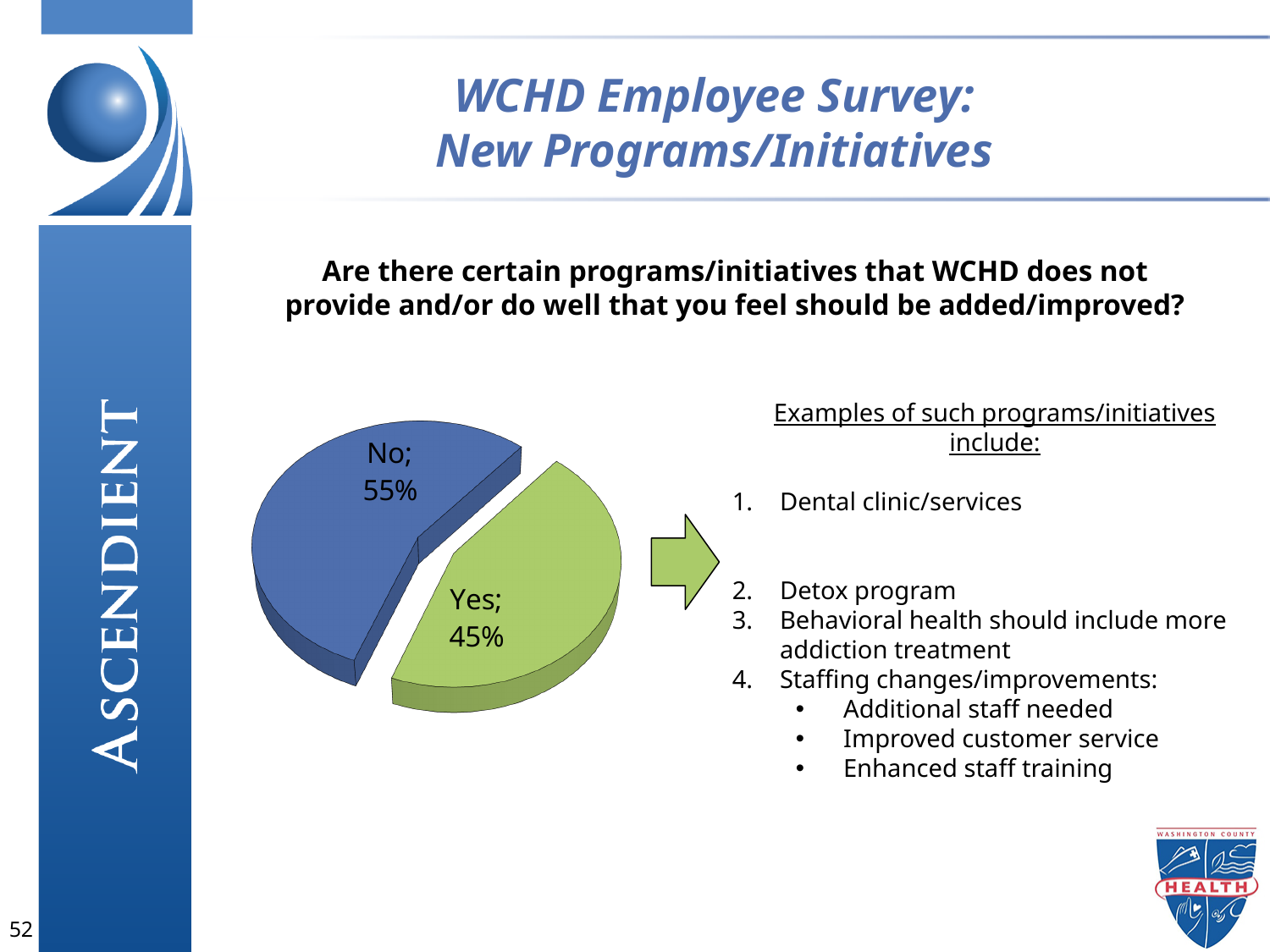
What share of the pie does the "No" slice represent? 55% Which response has the smaller share of the pie? Yes What percentage of respondents answered "No"? 55% What colour is the "No" slice of the pie chart? blue How many slices does the pie chart have? 2 Is the "Yes" slice larger or smaller than the "No" slice? smaller What colour is the "Yes" slice of the pie chart? green What kind of chart is shown on the slide? pie chart Which response has the larger share of the pie? No What percentage of respondents answered "Yes"? 45% What is the difference in percentage points between the "No" and "Yes" slices? 10